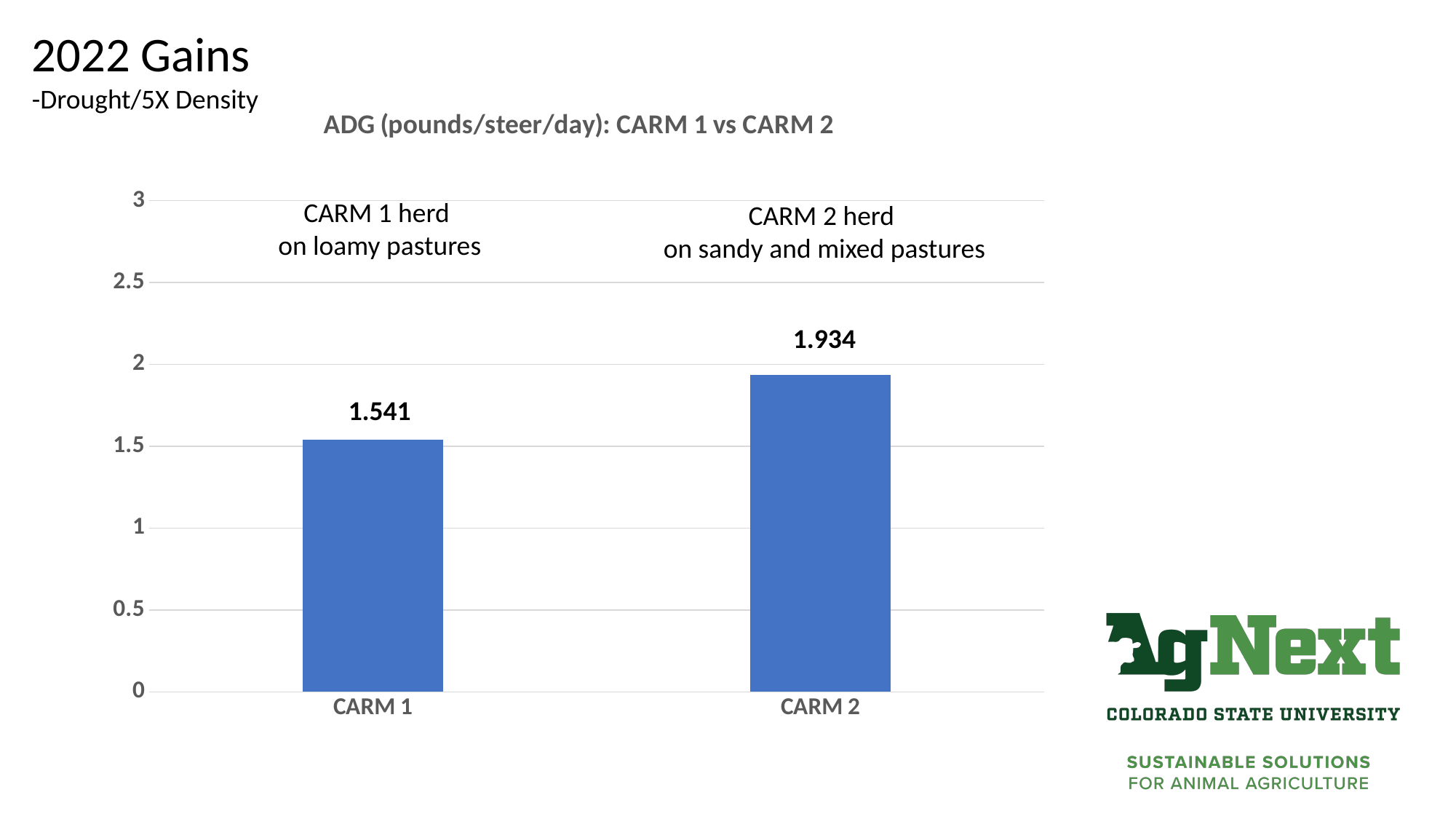
How many categories are shown on the chart? 2 What is the difference in ADG between CARM 2 and CARM 1? 0.393 What is the ADG value for CARM 1? 1.541 What kind of chart is shown on the slide? Bar chart According to the annotation on the chart, what type of pastures is the CARM 1 herd on? Loamy pastures Which category has the higher ADG, CARM 1 or CARM 2? CARM 2 What is the title of the chart? ADG (pounds/steer/day): CARM 1 vs CARM 2 Is the ADG for CARM 1 greater or less than 2? less What is the ADG value for CARM 2? 1.934 What is the highest value shown on the y axis? 3 Which category has the lowest ADG? CARM 1 Is the ADG for CARM 2 greater or less than 1.5? greater